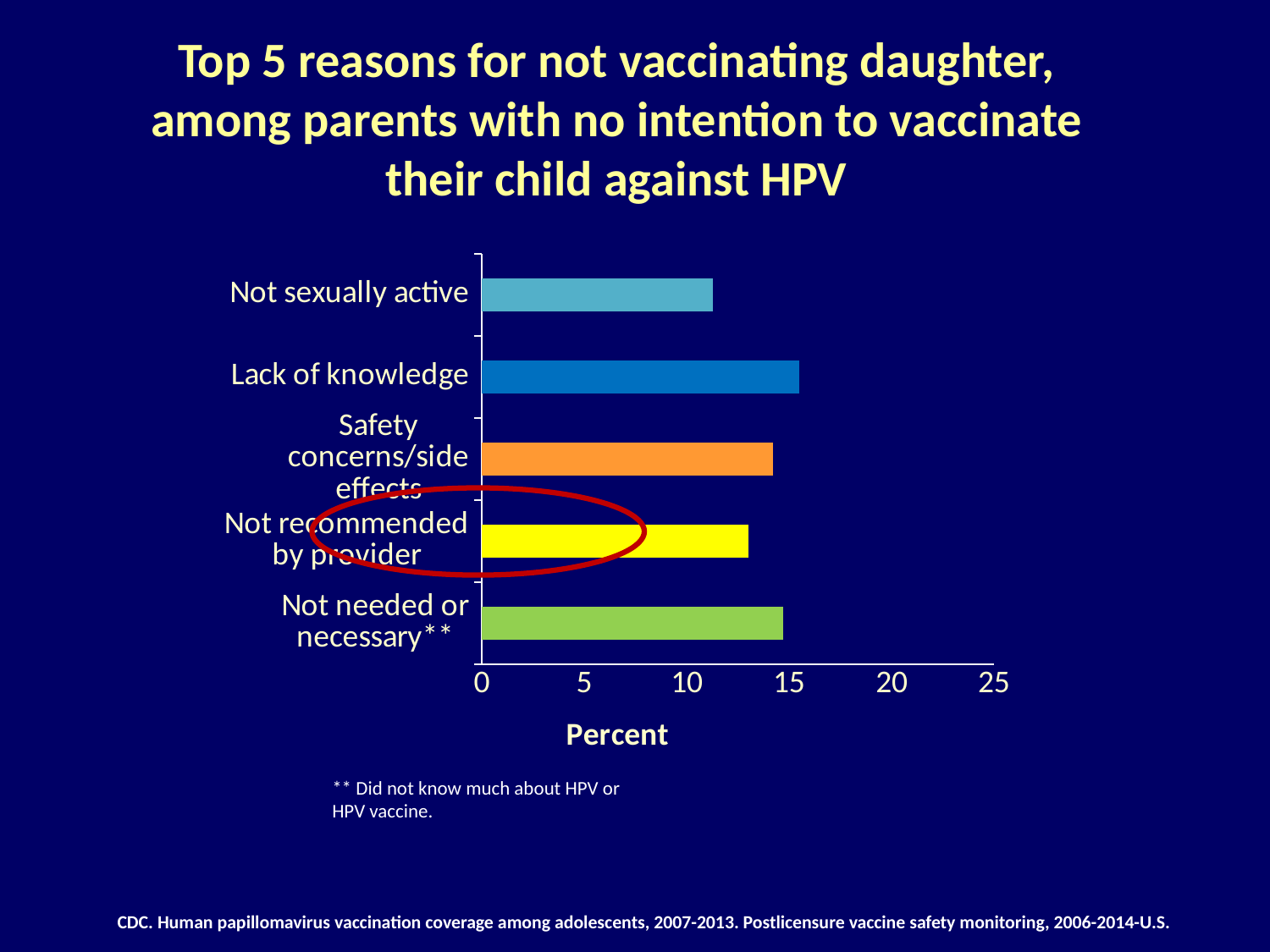
Which is larger, the value for Not sexually active or the value for Lack of knowledge? Lack of knowledge Is the value for Not recommended by provider greater or less than 10? greater How many reasons (categories) are plotted in the chart? 5 What kind of chart is shown on the slide? bar chart Is the value for Not sexually active greater or less than 15? less Which reason has the longest bar in the chart? Lack of knowledge Which reason has the shortest bar in the chart? Not sexually active Is the value for Lack of knowledge greater or less than 15? greater Which category's bar is circled in red on the chart? Not recommended by provider What is the label on the horizontal axis of the chart? Percent Which is larger, the value for Not recommended by provider or the value for Not sexually active? Not recommended by provider